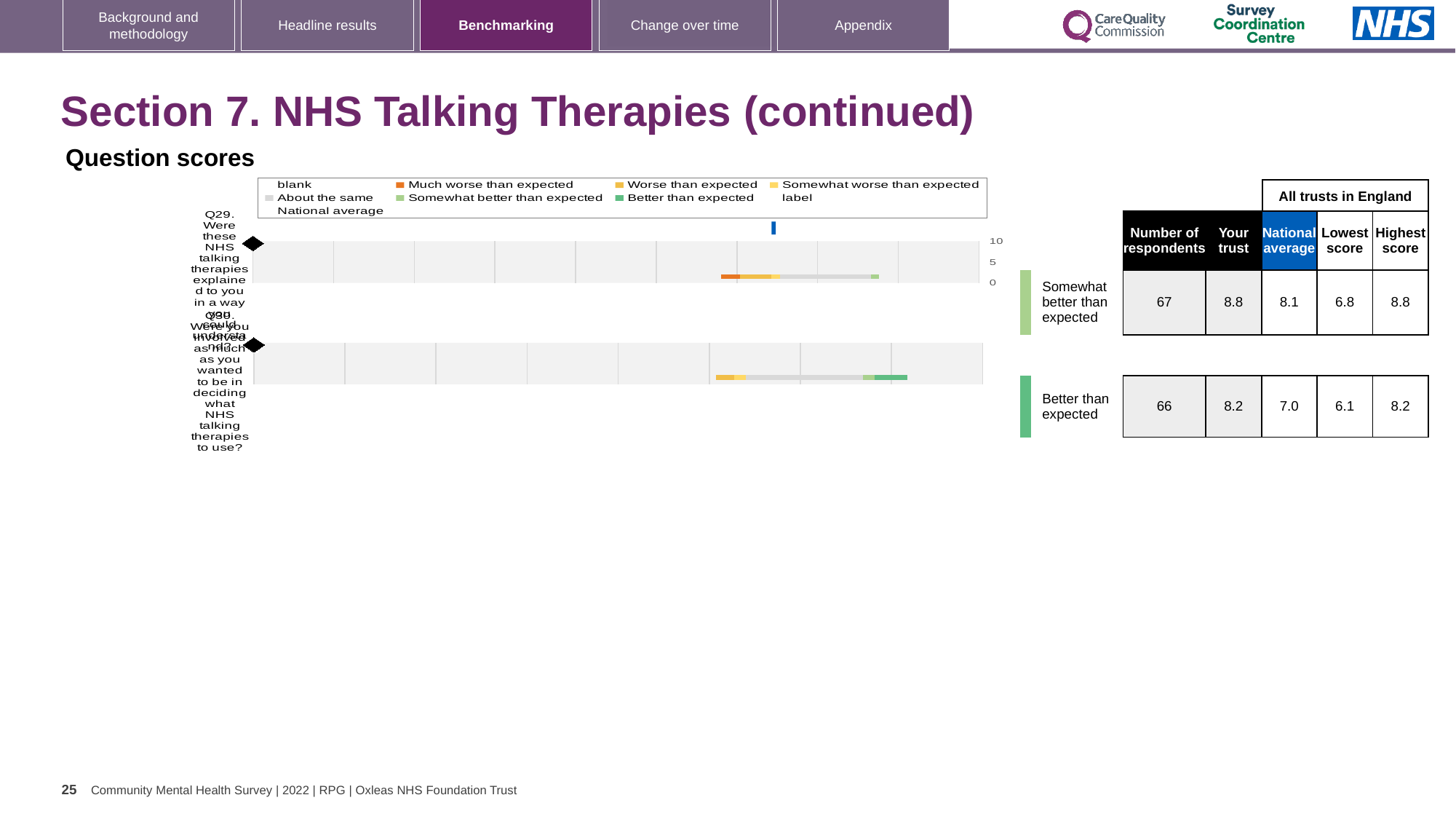
Which question has the higher 'Your trust' score, Q29 or Q30? Q29 What is the highest score among all trusts in England for Q29? 8.8 What benchmark category is Q30 rated as? Better than expected What is the difference between the 'Your trust' score and the national average for Q30? 1.2 How many questions are plotted in the Question scores chart? 2 What kind of chart is shown under 'Question scores'? bar chart How many respondents answered Q29? 67 What is the national average score for Q30? 7.0 What benchmark category is Q29 rated as? Somewhat better than expected Which question has the lower number of respondents, Q29 or Q30? Q30 What is the lowest score among all trusts in England for Q30? 6.1 What is the 'Your trust' score for Q29? 8.8